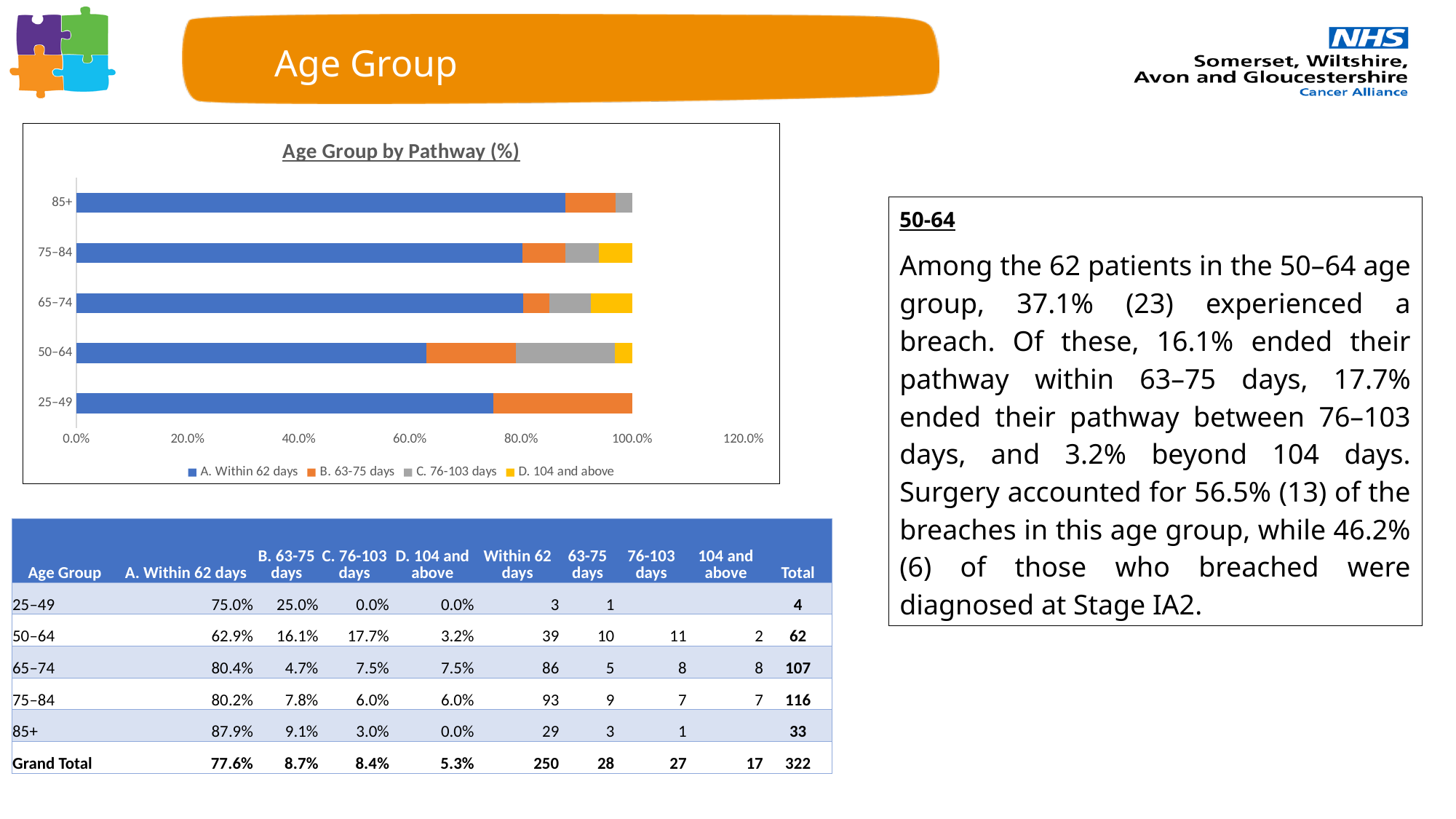
What is the 'A. Within 62 days' percentage for the 25–49 age group? 75.0% What colour represents 'D. 104 and above' in the 'Age Group by Pathway (%)' chart? Yellow Which age group has the highest 'A. Within 62 days' share in the 'Age Group by Pathway (%)' chart? 85+ Which age group has the lowest 'A. Within 62 days' share in the 'Age Group by Pathway (%)' chart? 50–64 How many series does the legend of the 'Age Group by Pathway (%)' chart list? 4 What is the difference in 'A. Within 62 days' percentage between the 85+ and 50–64 age groups? 25.0 percentage points What is the title of the chart on the slide? Age Group by Pathway (%) In the 'Age Group by Pathway (%)' chart, is the 'A. Within 62 days' value for 50–64 greater or less than 80.0%? less Which age group has the larger 'B. 63-75 days' share, 25–49 or 50–64? 25–49 What kind of chart is 'Age Group by Pathway (%)'? Stacked bar chart In the 'Age Group by Pathway (%)' chart, is the 'A. Within 62 days' value for 85+ greater or less than 80.0%? greater How many age groups are plotted in the 'Age Group by Pathway (%)' chart? 5